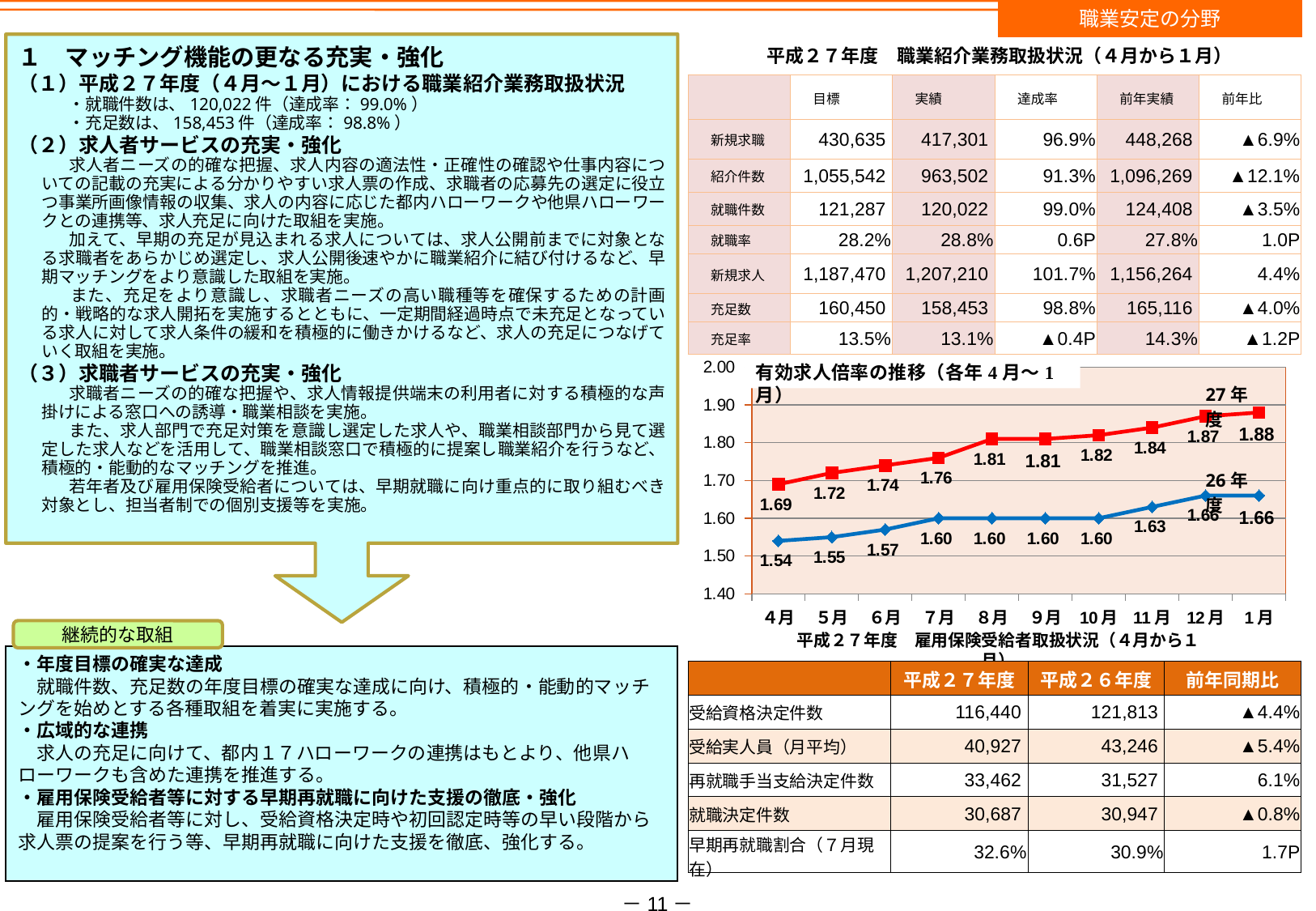
In the 有効求人倍率の推移 chart, what is the value for 26年度 in 1月? 1.66 How many months are plotted on the x axis of the 有効求人倍率の推移 chart? 10 In the 有効求人倍率の推移 chart, what is the difference between the 27年度 and 26年度 values in 1月? 0.22 In the 有効求人倍率の推移 chart, which series has the higher value in 8月, 27年度 or 26年度? 27年度 What kind of chart is 有効求人倍率の推移（各年4月～1月）? line chart In the 有効求人倍率の推移 chart, is the value for 26年度 in 4月 greater or less than 1.60? less In the 有効求人倍率の推移 chart, which month has the highest value for 27年度? 1月 In the 有効求人倍率の推移 chart, which month has the lowest value for 26年度? 4月 In the 有効求人倍率の推移 chart, what is the value for 27年度 in 4月? 1.69 In the 有効求人倍率の推移 chart, what is the value for 26年度 in 7月? 1.60 In the 有効求人倍率の推移 chart, do the 27年度 values generally rise or fall from 4月 to 1月? rise In the 有効求人倍率の推移 chart, what is the value for 27年度 in 12月? 1.87